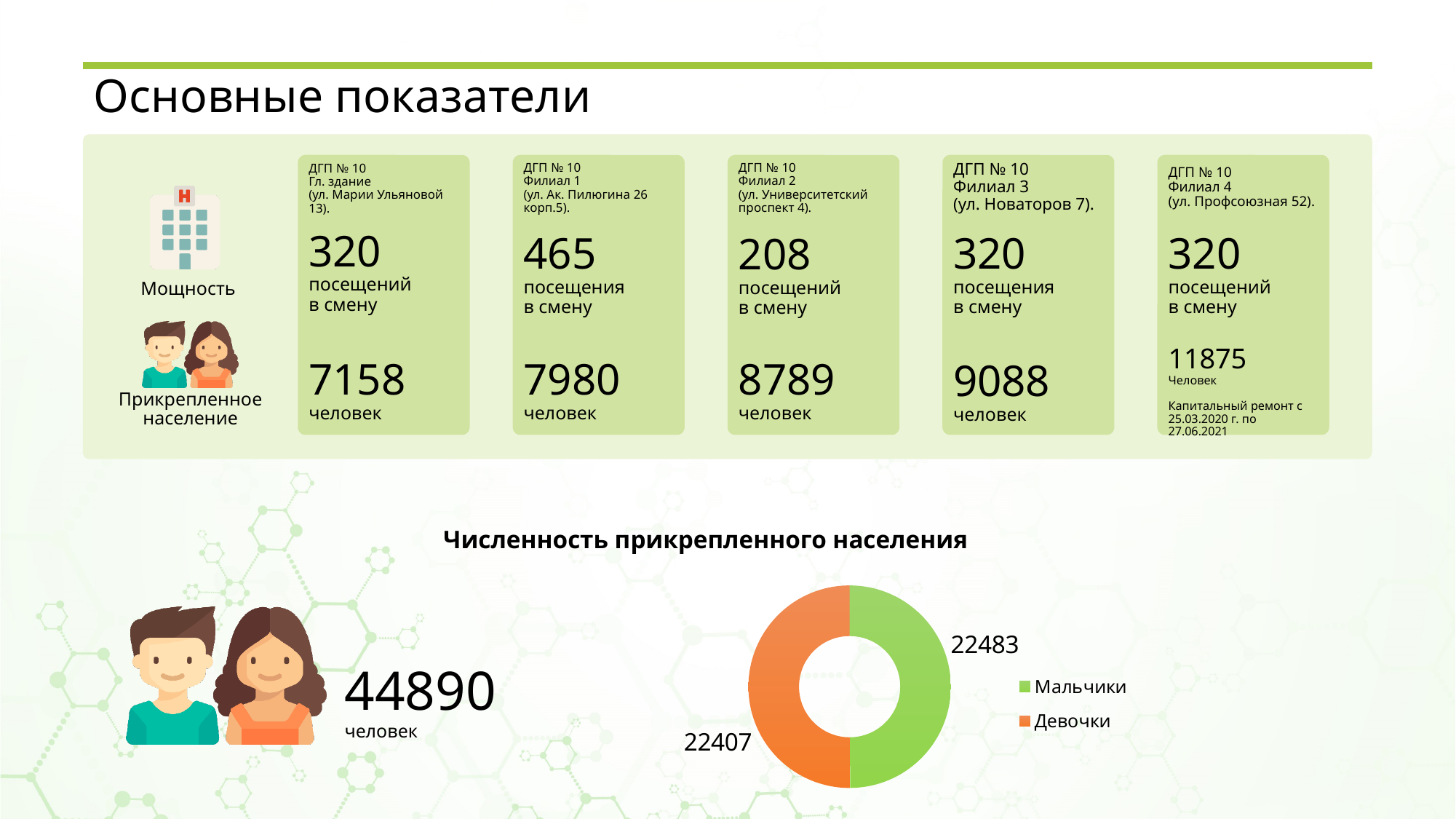
Which category has the larger value in the doughnut chart, Мальчики or Девочки? Мальчики Which category has the largest value in the doughnut chart? Мальчики Which category has the smallest value in the doughnut chart? Девочки What is the total of the two values shown in the doughnut chart? 44890 Which colour represents Девочки in the doughnut chart? Orange What is the value for Девочки in the doughnut chart? 22407 What kind of chart is shown at the bottom of the slide? Doughnut (pie) chart What is the difference between the values for Мальчики and Девочки in the doughnut chart? 76 How many entries does the legend of the doughnut chart list? 2 What is the value for Мальчики in the doughnut chart? 22483 What is the title of the chart on the slide? Численность прикрепленного населения How many categories does the doughnut chart show? 2